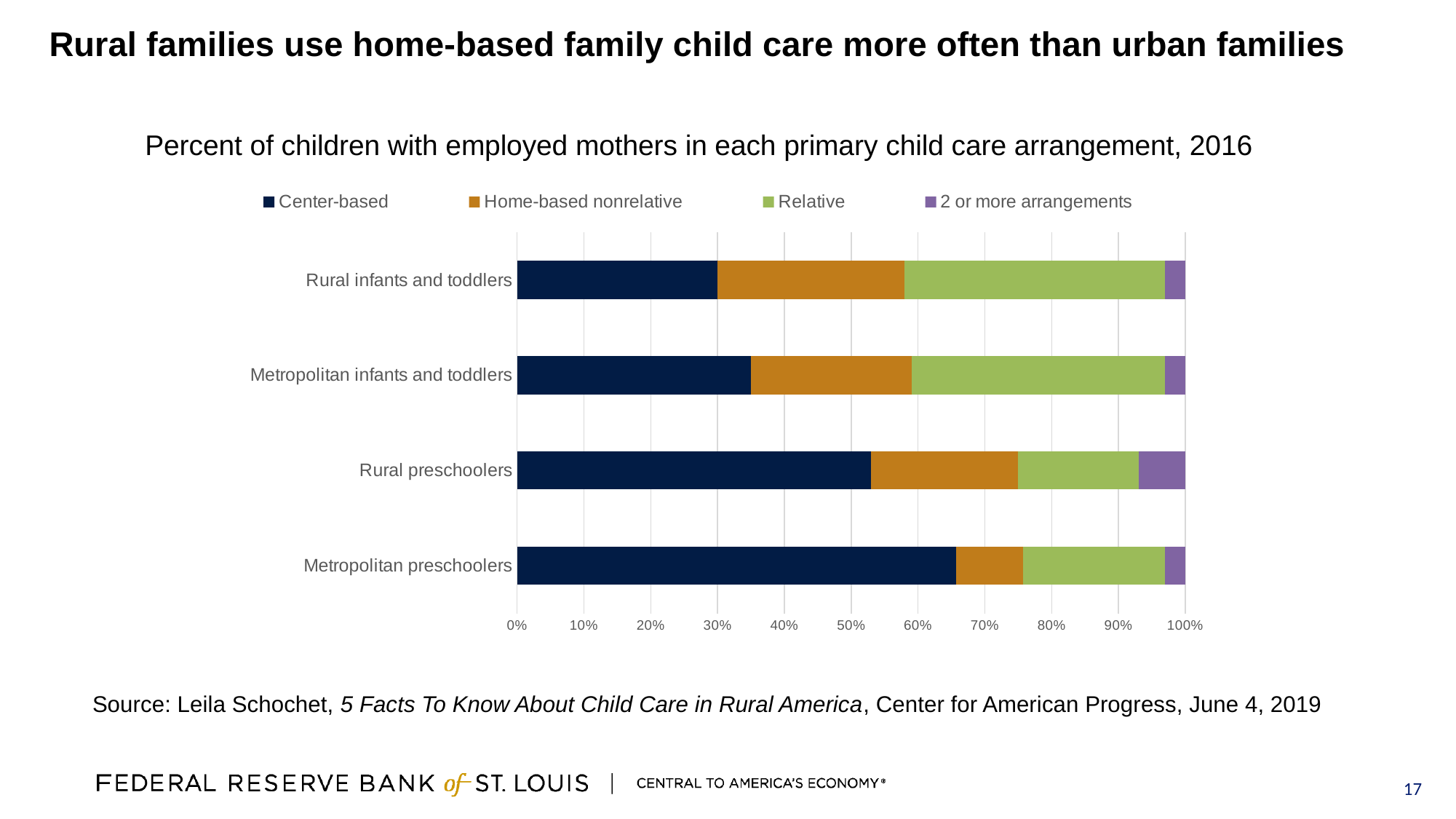
What kind of chart is shown on the slide? Stacked bar chart How many categories (bars) are shown on the chart? 4 Is the Center-based value for Metropolitan preschoolers greater or less than 60%? greater Which has the larger Home-based nonrelative segment: Rural preschoolers or Metropolitan preschoolers? Rural preschoolers Is the Center-based value for Rural preschoolers greater or less than 40%? greater Which has the larger Center-based segment: Rural preschoolers or Metropolitan preschoolers? Metropolitan preschoolers Which category has the largest Center-based segment? Metropolitan preschoolers What colour represents the Relative series in the legend? Green How many series does the legend list? 4 Which category has the smallest Center-based segment? Rural infants and toddlers Which category has the largest '2 or more arrangements' segment? Rural preschoolers Is the Center-based value for Rural infants and toddlers greater or less than 40%? less